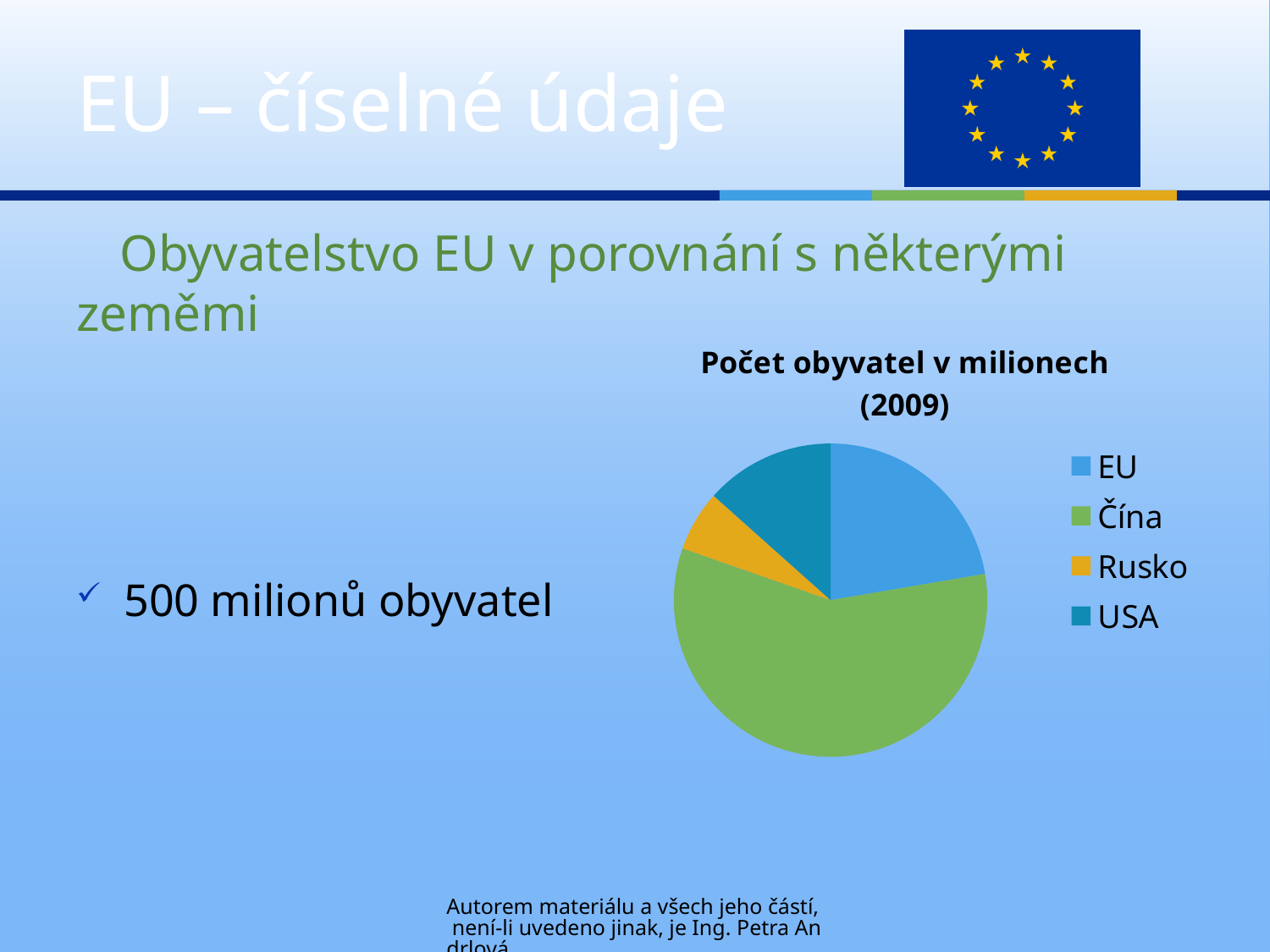
Which has the larger slice in the pie chart, Čína or EU? Čína Which has the larger slice in the pie chart, EU or USA? EU How many entries does the legend of the pie chart list? 4 Which country or region has the largest slice in the pie chart? Čína What is the title of the pie chart? Počet obyvatel v milionech (2009) Which has the larger slice in the pie chart, USA or Rusko? USA What kind of chart is shown on the slide? pie chart Which country or region has the smallest slice in the pie chart? Rusko Which legend entry is shown in green in the pie chart? Čína How many slices does the pie chart have? 4